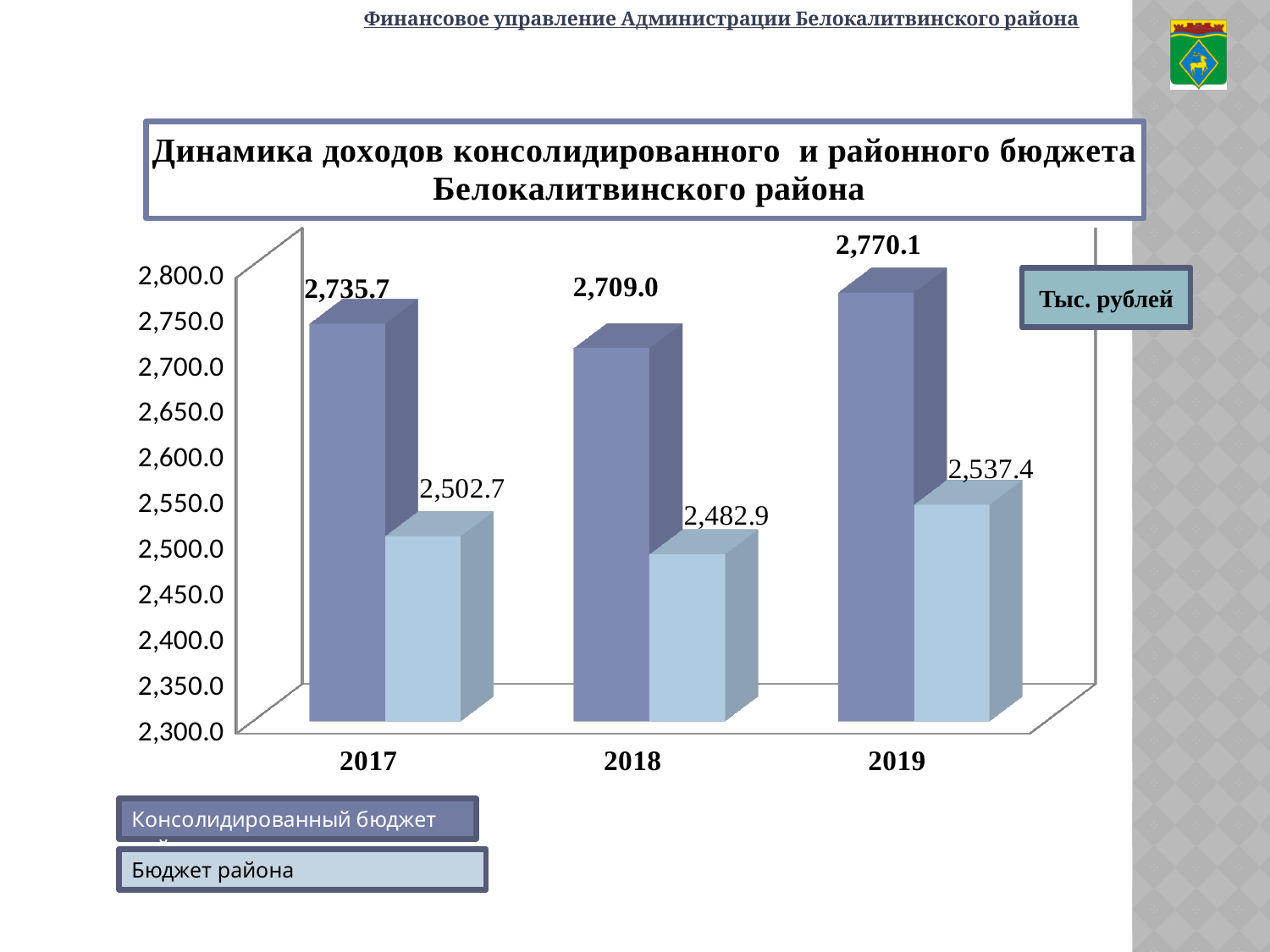
What unit of measurement is indicated for the chart values? Тыс. рублей What is the value for Бюджет района in 2018? 2,482.9 How many years are shown on the x axis? 3 What is the difference between Консолидированный бюджет and Бюджет района in 2017? 233.0 What kind of chart is shown on the slide? Bar chart Which is larger: Консолидированный бюджет in 2018 or Консолидированный бюджет in 2017? Консолидированный бюджет in 2017 What is the value for Бюджет района in 2019? 2,537.4 What is the value for Консолидированный бюджет in 2017? 2,735.7 How many series does the legend list? 2 What is the value for Консолидированный бюджет in 2019? 2,770.1 In which year is the Бюджет района value lowest? 2018 In which year is the Консолидированный бюджет value highest? 2019